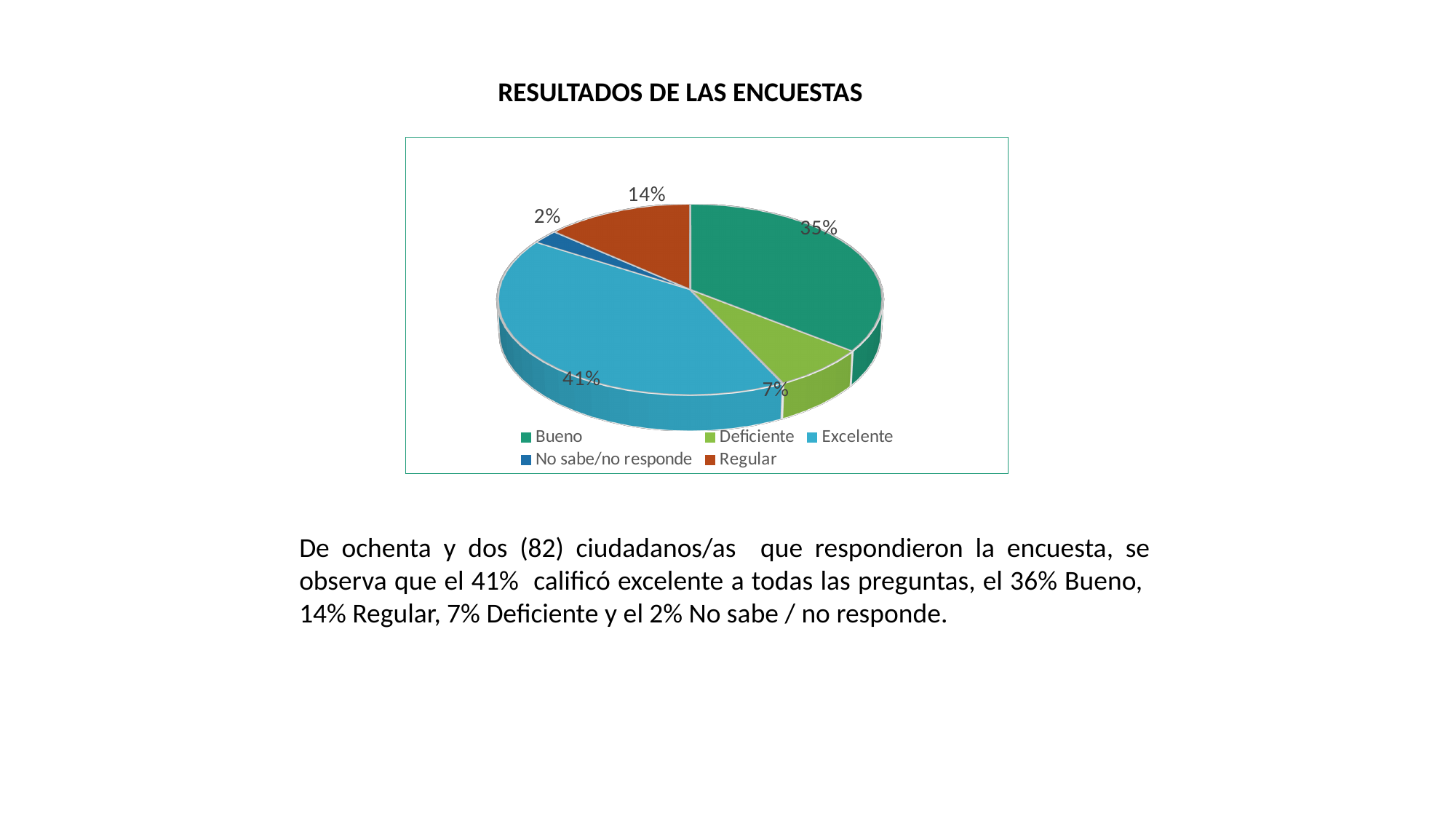
What share of the pie does Excelente have? 41% What colour is the Regular slice? red-brown What share of the pie does Deficiente have? 7% What kind of chart is shown on the slide? pie chart What share of the pie does Bueno have? 35% What is the difference between the Excelente and Bueno shares? 6% Which is larger, the Regular slice or the Deficiente slice? Regular Which category has the largest slice of the pie? Excelente Which category has the smallest slice of the pie? No sabe/no responde How many categories does the legend list? 5